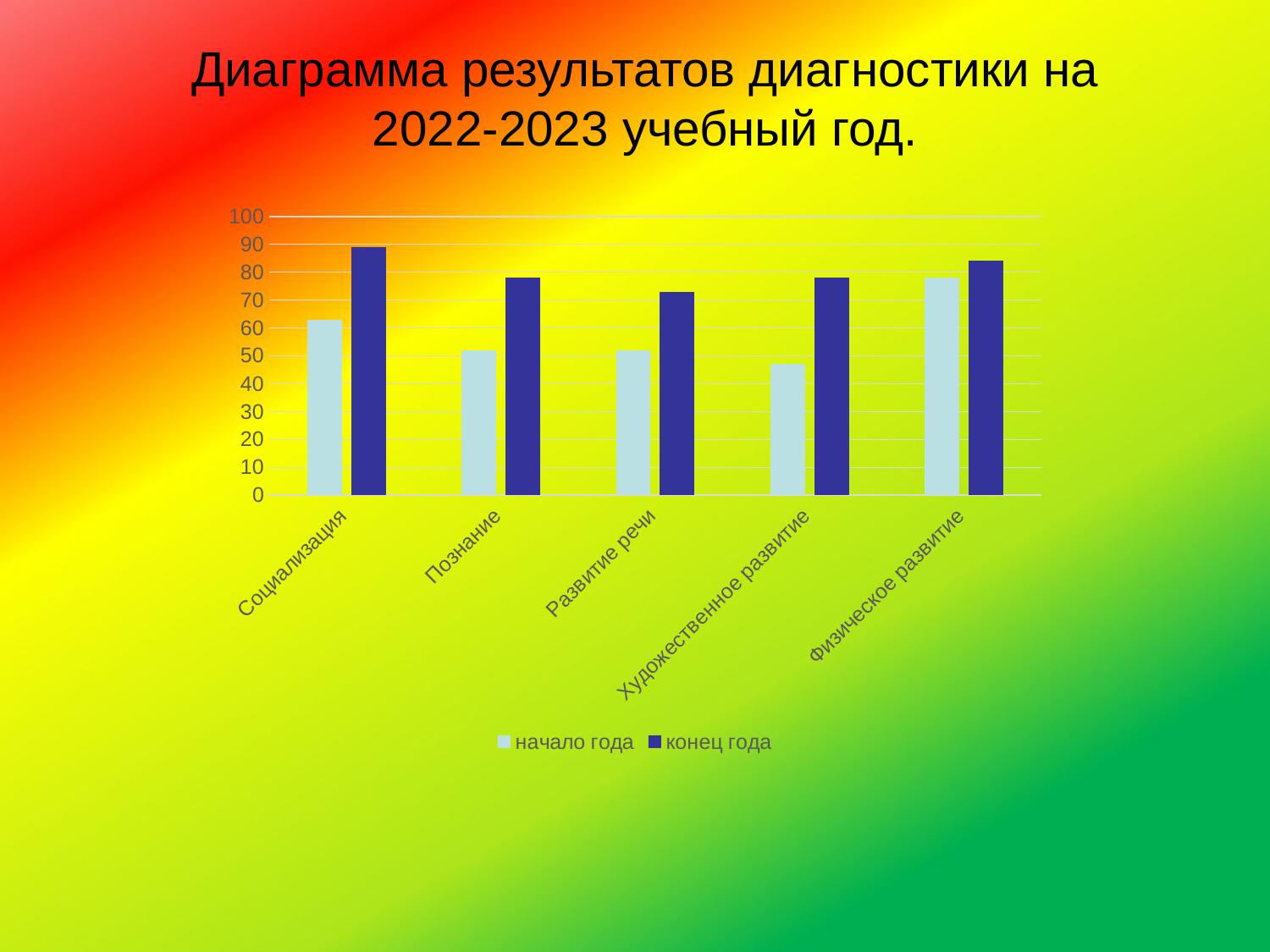
Is the value for конец года in Социализация greater or less than 80? greater Is the value for начало года in Художественное развитие greater or less than 60? less What are the two series named in the legend? начало года, конец года Is the value for конец года in Развитие речи greater or less than 80? less For начало года, which is larger: Социализация or Физическое развитие? Физическое развитие For конец года, which is larger: Познание or Развитие речи? Познание Which category has the highest value for конец года? Социализация How many categories are shown on the x axis of the chart? 5 What kind of chart is shown on the slide? bar chart Which category has the lowest value for начало года? Художественное развитие How many series does the legend list? 2 Which category has the highest value for начало года? Физическое развитие